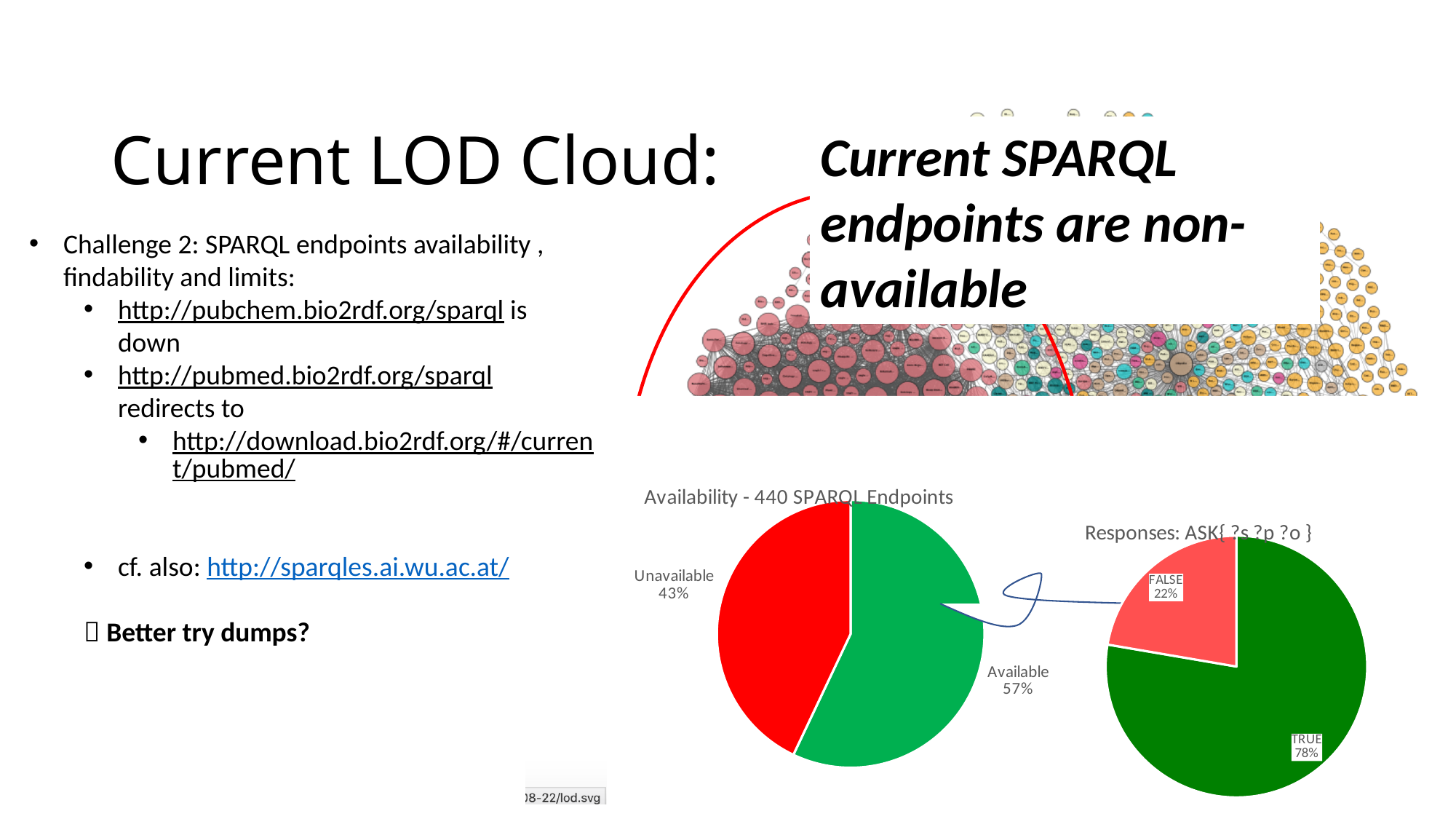
In the 'Availability - 440 SPARQL Endpoints' chart, what is the difference in percentage points between the Available and Unavailable slices? 14 In the 'Responses: ASK{ ?s ?p ?o }' chart, what share of responses is TRUE? 78% In the 'Availability - 440 SPARQL Endpoints' chart, what share of endpoints is Unavailable? 43% In the 'Availability - 440 SPARQL Endpoints' chart, what share of endpoints is Available? 57% In the 'Responses: ASK{ ?s ?p ?o }' chart, what is the difference in percentage points between the TRUE and FALSE slices? 56 How many SPARQL endpoints does the title of the left pie chart say were assessed? 440 In the 'Availability - 440 SPARQL Endpoints' chart, which slice is larger, Available or Unavailable? Available What colour is the Unavailable slice in the 'Availability - 440 SPARQL Endpoints' chart? Red How many slices does the 'Responses: ASK{ ?s ?p ?o }' chart have? 2 In the 'Responses: ASK{ ?s ?p ?o }' chart, which slice is the smallest? FALSE In the 'Responses: ASK{ ?s ?p ?o }' chart, what share of responses is FALSE? 22% What kind of chart is the 'Availability - 440 SPARQL Endpoints' chart? Pie chart